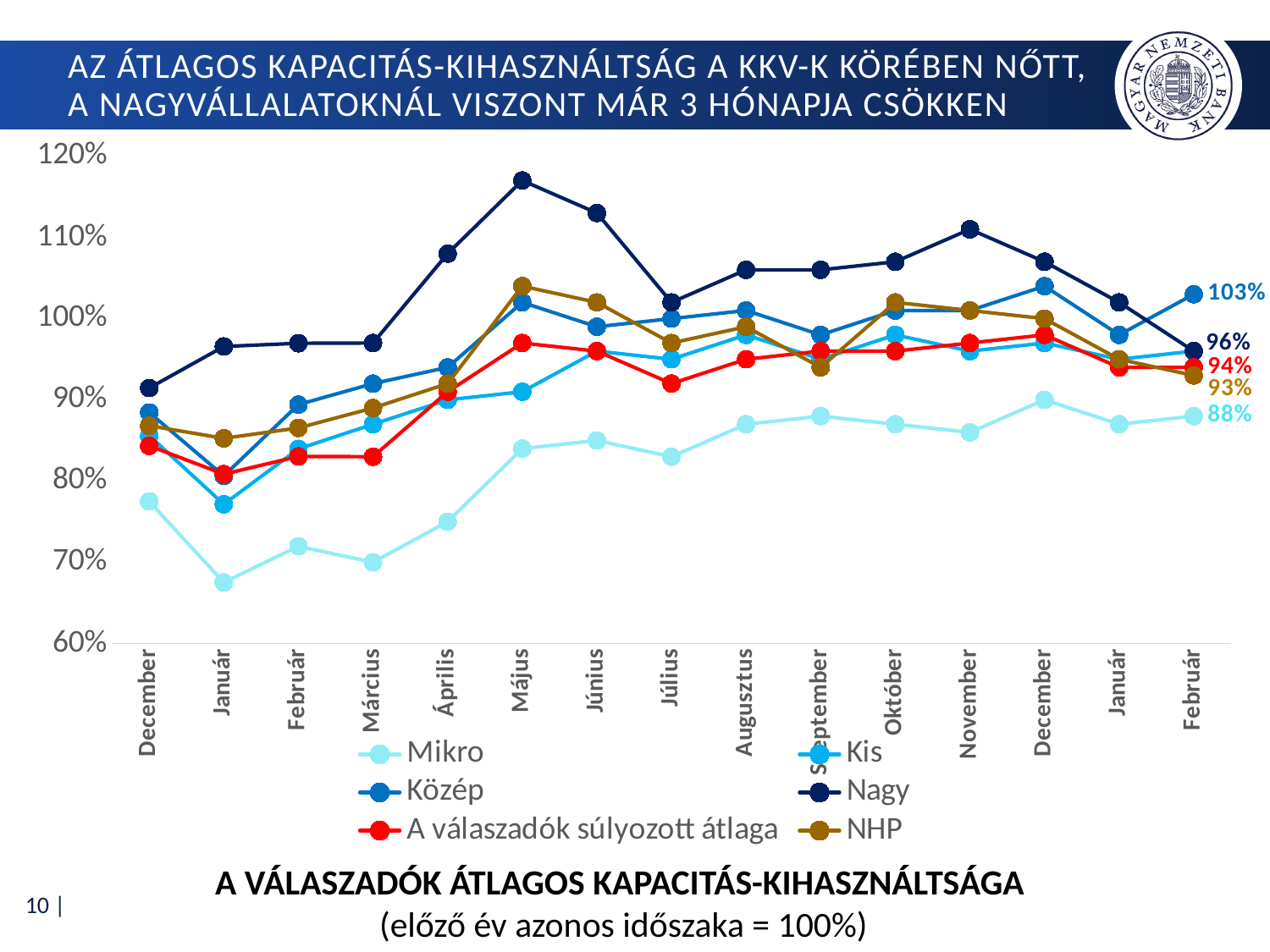
How many series does the legend list? 6 Which series has the lowest value in Január? Mikro Which series has the highest value in Május? Nagy What is the value for Nagy at the final Február point? 96% At the final Február point, what is the difference between the Közép value and the Mikro value? 15 percentage points What is the value for Közép at the final Február point? 103% What is the value for Mikro at the final Február point? 88% Is the value for Nagy in Május greater or less than 110%? greater What is the value for 'A válaszadók súlyozott átlaga' at the final Február point? 94% What is the value for NHP at the final Február point? 93% How many months are plotted along the x axis? 15 What type of chart is shown on the slide? Line chart